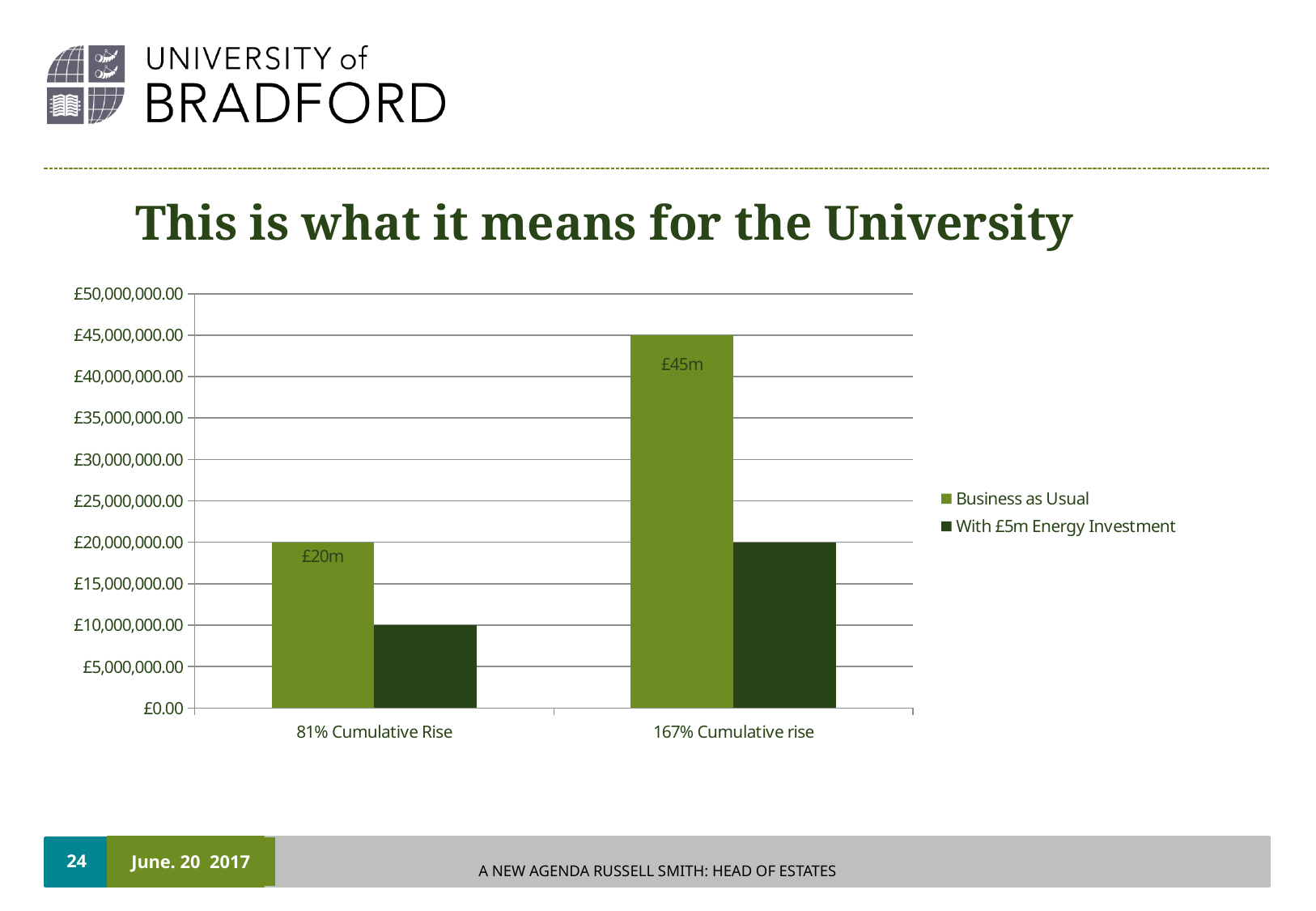
What is the With £5m Energy Investment value for the 81% Cumulative Rise category? £10,000,000.00 Which category has the highest Business as Usual value? 167% Cumulative rise Is the Business as Usual value for 167% Cumulative rise greater or less than £40,000,000.00? greater For the 167% Cumulative rise category, which is larger: Business as Usual or With £5m Energy Investment? Business as Usual What kind of chart is shown on the slide? Bar chart What is the With £5m Energy Investment value for the 167% Cumulative rise category? £20,000,000.00 What is the difference between the Business as Usual values for 167% Cumulative rise and 81% Cumulative Rise? £25m What is the Business as Usual value for the 81% Cumulative Rise category? £20m What is the Business as Usual value for the 167% Cumulative rise category? £45m How many series does the legend list? 2 Which category has the lowest With £5m Energy Investment value? 81% Cumulative Rise How many categories are shown on the x axis? 2